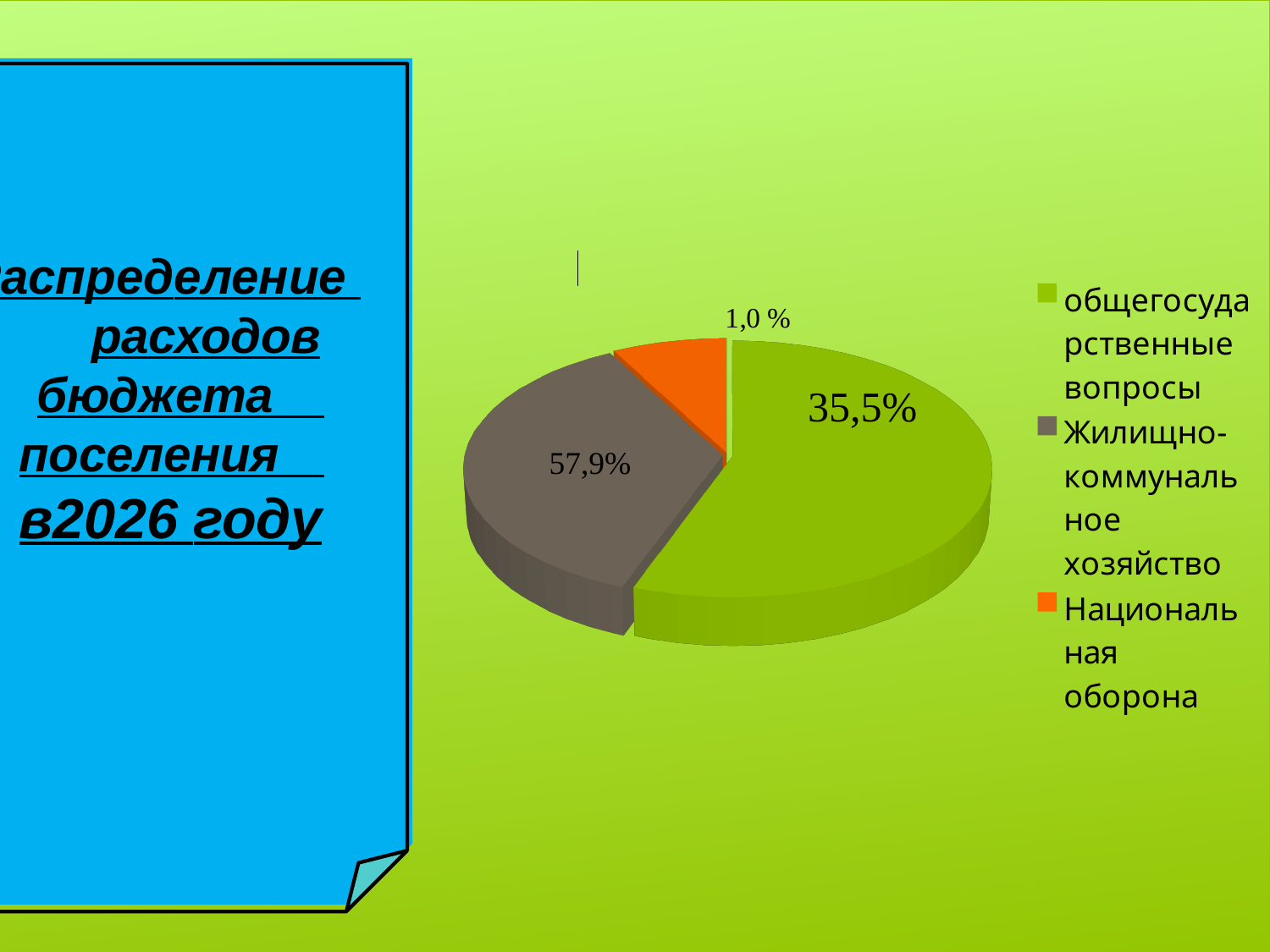
What colour is the slice for Национальная оборона? orange Which category has the largest labelled share of the pie? Жилищно-коммунальное хозяйство How many entries does the legend list? 3 How many slices does the pie chart have? 3 What kind of chart is shown on the slide? pie chart By how many percentage points does the share for общегосударственные вопросы exceed that for Национальная оборона? 34,5% By how many percentage points does the labelled share for Жилищно-коммунальное хозяйство exceed that for общегосударственные вопросы? 22,4% Which category has the smallest slice of the pie? Национальная оборона What share of the pie is labelled for общегосударственные вопросы? 35,5% What share of the pie is labelled for Национальная оборона? 1,0 % What share of the pie is labelled for Жилищно-коммунальное хозяйство? 57,9% Which has the larger share: общегосударственные вопросы or Национальная оборона? общегосударственные вопросы